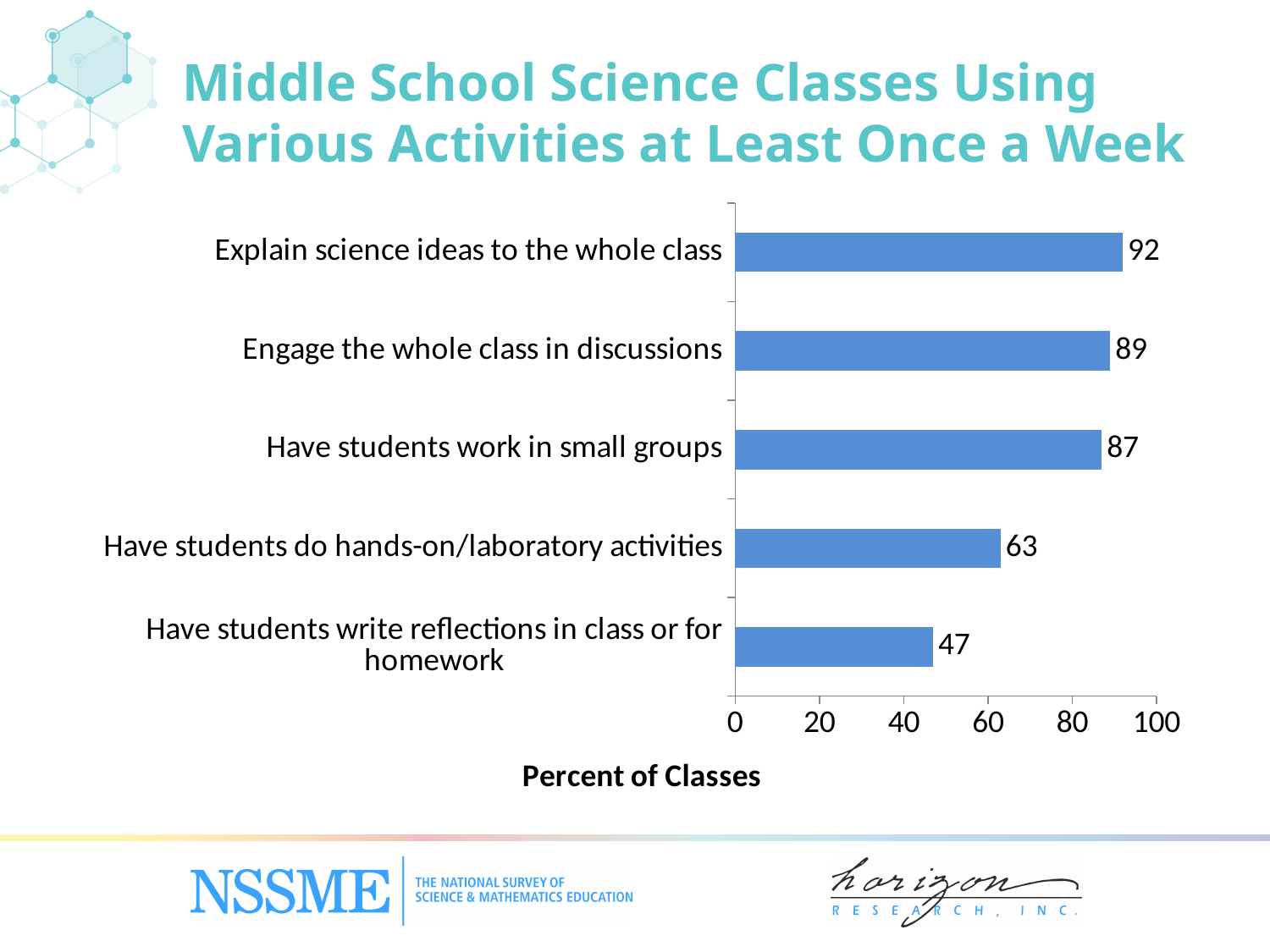
Which is larger: the value for 'Have students work in small groups' or 'Have students do hands-on/laboratory activities'? Have students work in small groups Which activity has the highest percent of classes? Explain science ideas to the whole class What is the difference between 'Have students work in small groups' and 'Have students do hands-on/laboratory activities'? 24 What is the label of the horizontal axis? Percent of Classes Which activity has the lowest percent of classes? Have students write reflections in class or for homework What kind of chart is shown on the slide? bar chart What is the difference between the values for 'Explain science ideas to the whole class' and 'Have students write reflections in class or for homework'? 45 What is the value for 'Have students write reflections in class or for homework'? 47 How many activities are shown in the chart? 5 What is the value for 'Engage the whole class in discussions'? 89 Is the value for 'Have students write reflections in class or for homework' greater or less than 60? less What percent of classes have students do hands-on/laboratory activities at least once a week? 63